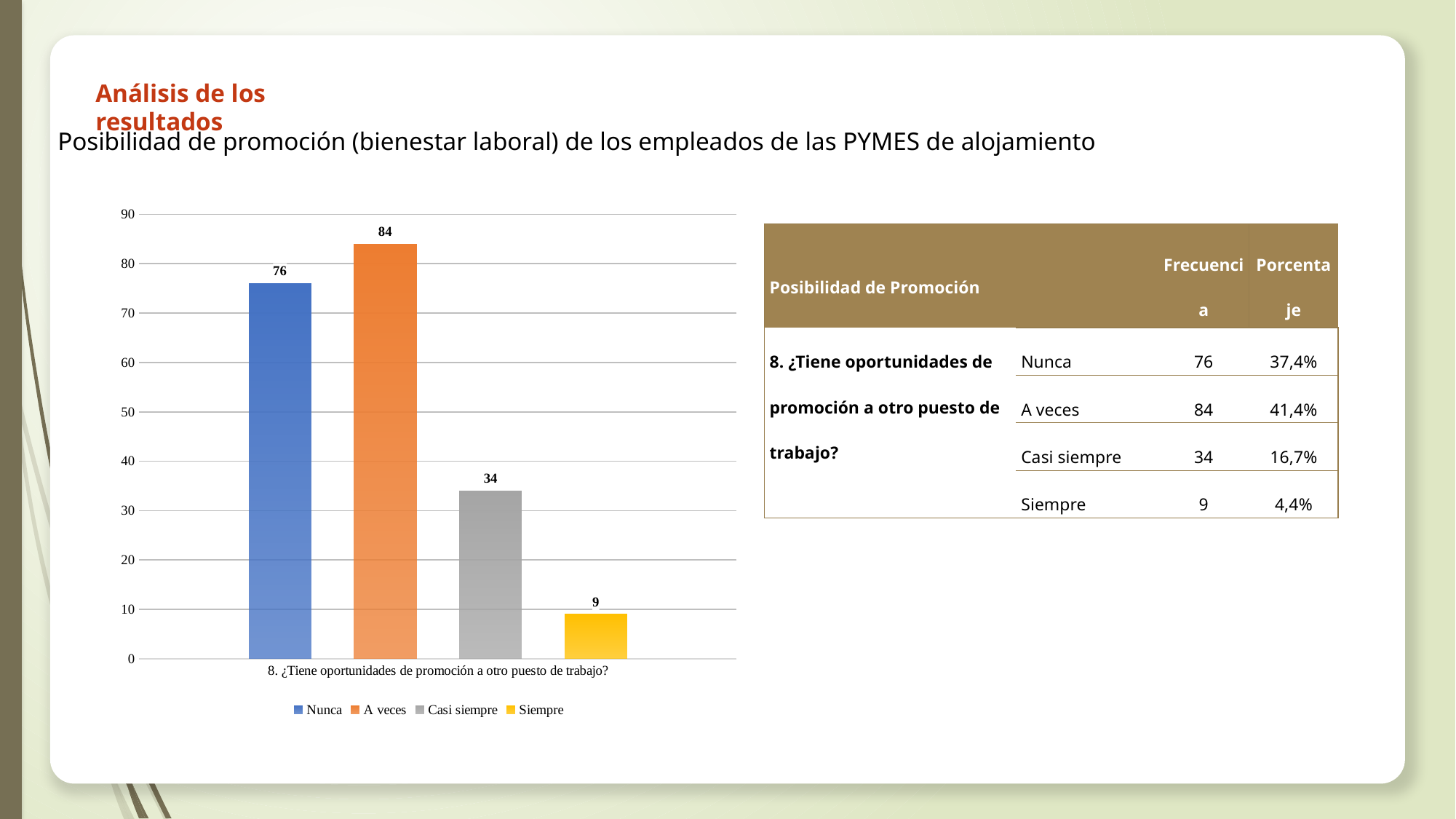
What is the value for Casi siempre in the bar chart? 34 What colour is the bar for Siempre in the bar chart? Yellow What is the value for A veces in the bar chart? 84 What is the difference between the values for Casi siempre and Siempre in the bar chart? 25 How many series does the legend of the bar chart list? 4 Which series has the highest value in the bar chart? A veces Which is larger in the bar chart, Nunca or Casi siempre? Nunca What is the value for Nunca in the bar chart? 76 Which series has the lowest value in the bar chart? Siempre What is the difference between the values for A veces and Nunca in the bar chart? 8 What is the value for Siempre in the bar chart? 9 What kind of chart is shown on the slide? Bar chart